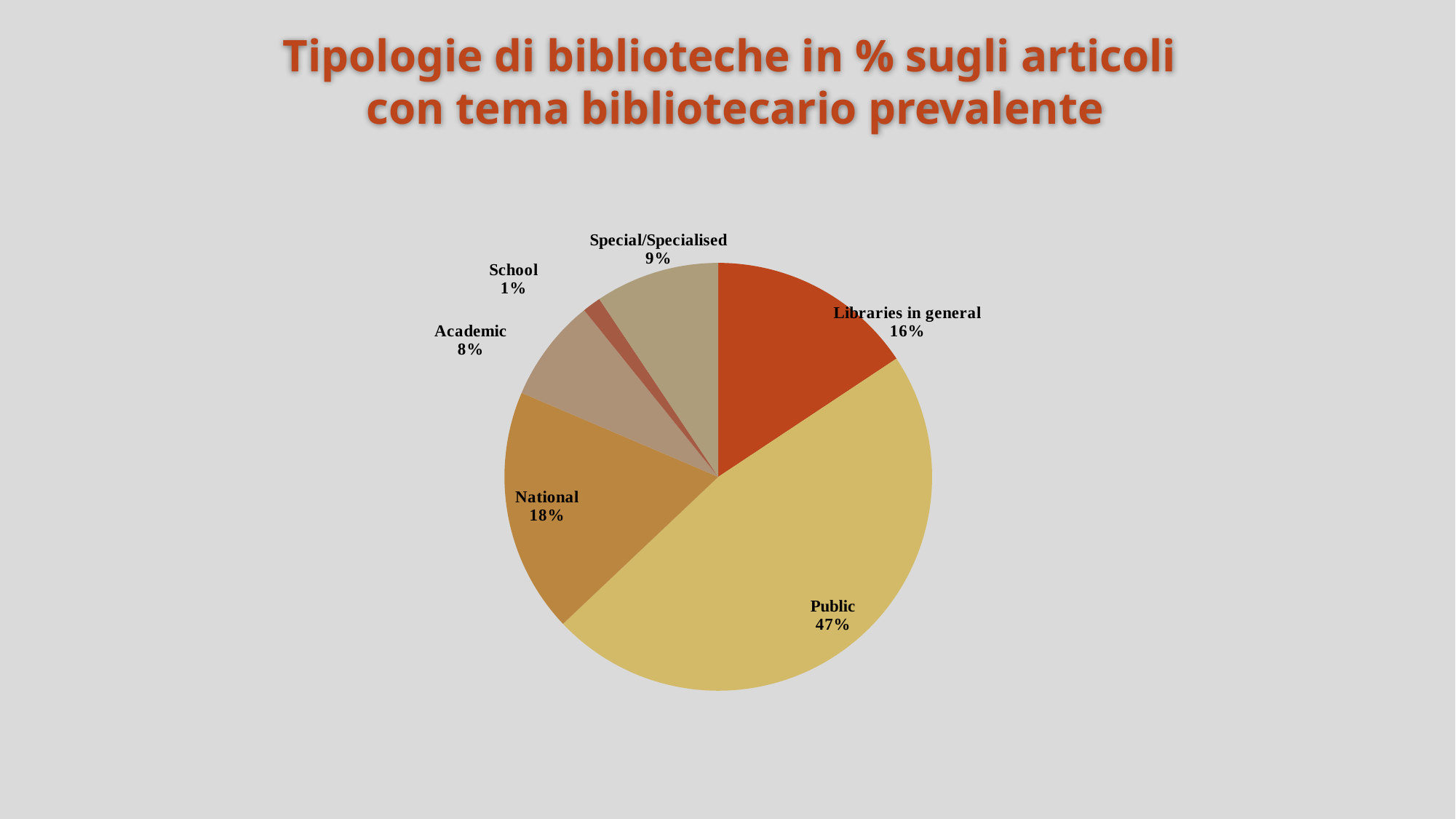
What kind of chart is shown on the slide? Pie chart What is the value shown for National? 18% Which category has the largest slice of the pie? Public What percentage is shown for School? 1% What percentage of the pie does the Public slice represent? 47% Which category has the smallest slice of the pie? School Which is larger, the Academic slice or the Special/Specialised slice? Special/Specialised What percentage is shown for Libraries in general? 16% How many categories are shown in the pie chart? 6 What is the difference in percentage points between National and Libraries in general? 2 What is the title of the chart? Tipologie di biblioteche in % sugli articoli con tema bibliotecario prevalente What is the value for Special/Specialised? 9%